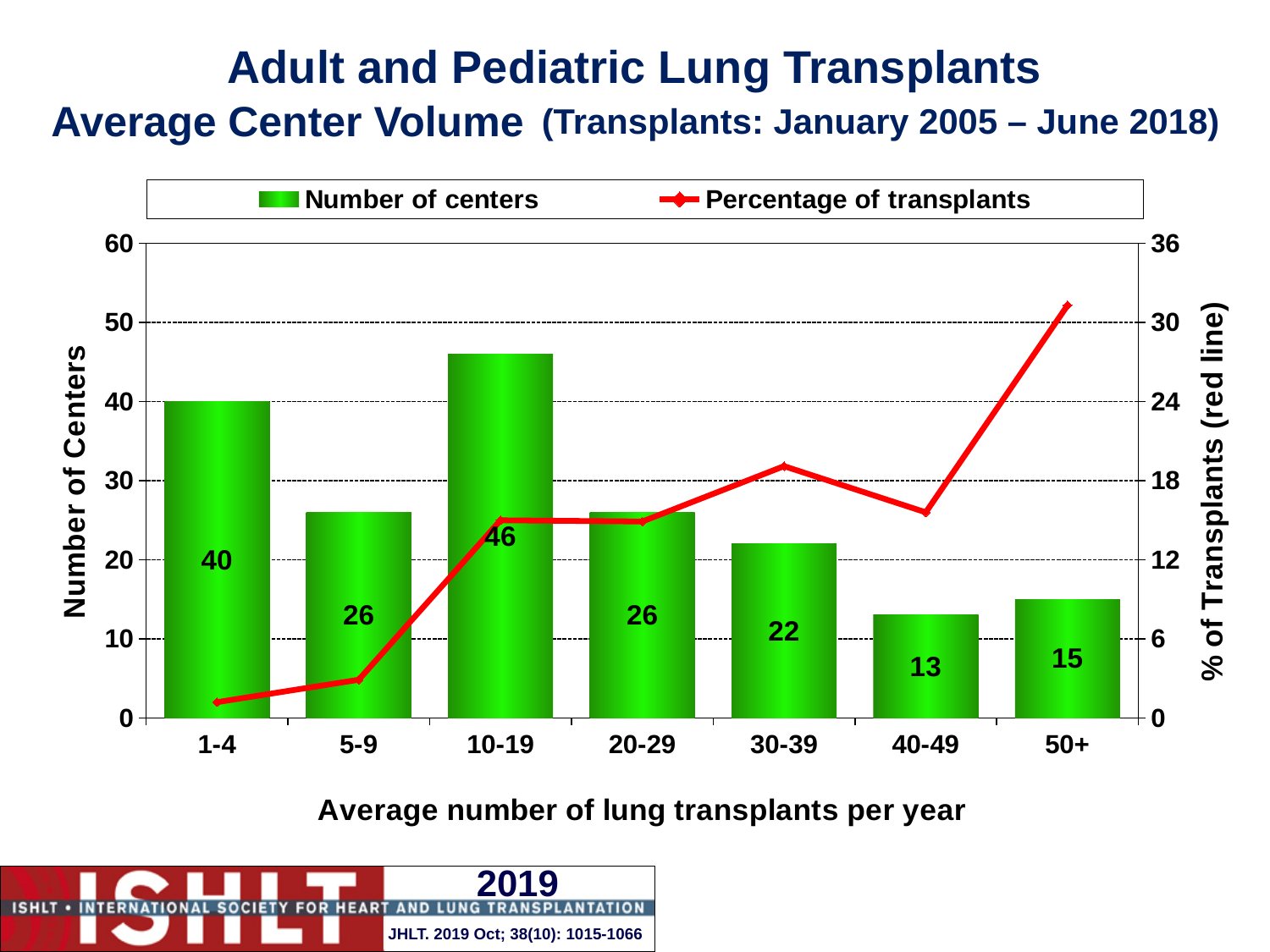
How many categories of average number of lung transplants per year are shown on the x axis? 7 Which category has the highest number of centers? 10-19 How many centers are in the 1-4 category? 40 What is the difference in number of centers between the 10-19 and 1-4 categories? 6 Is the percentage of transplants for the 5-9 category greater or less than 6? less Is the percentage of transplants for the 50+ category greater or less than 24? greater Which category has the lowest number of centers? 40-49 What does the red line represent according to the legend? Percentage of transplants How many centers are in the 10-19 category? 46 How many series does the legend list? 2 Which has more centers, the 30-39 category or the 50+ category? 30-39 How many centers are in the 40-49 category? 13